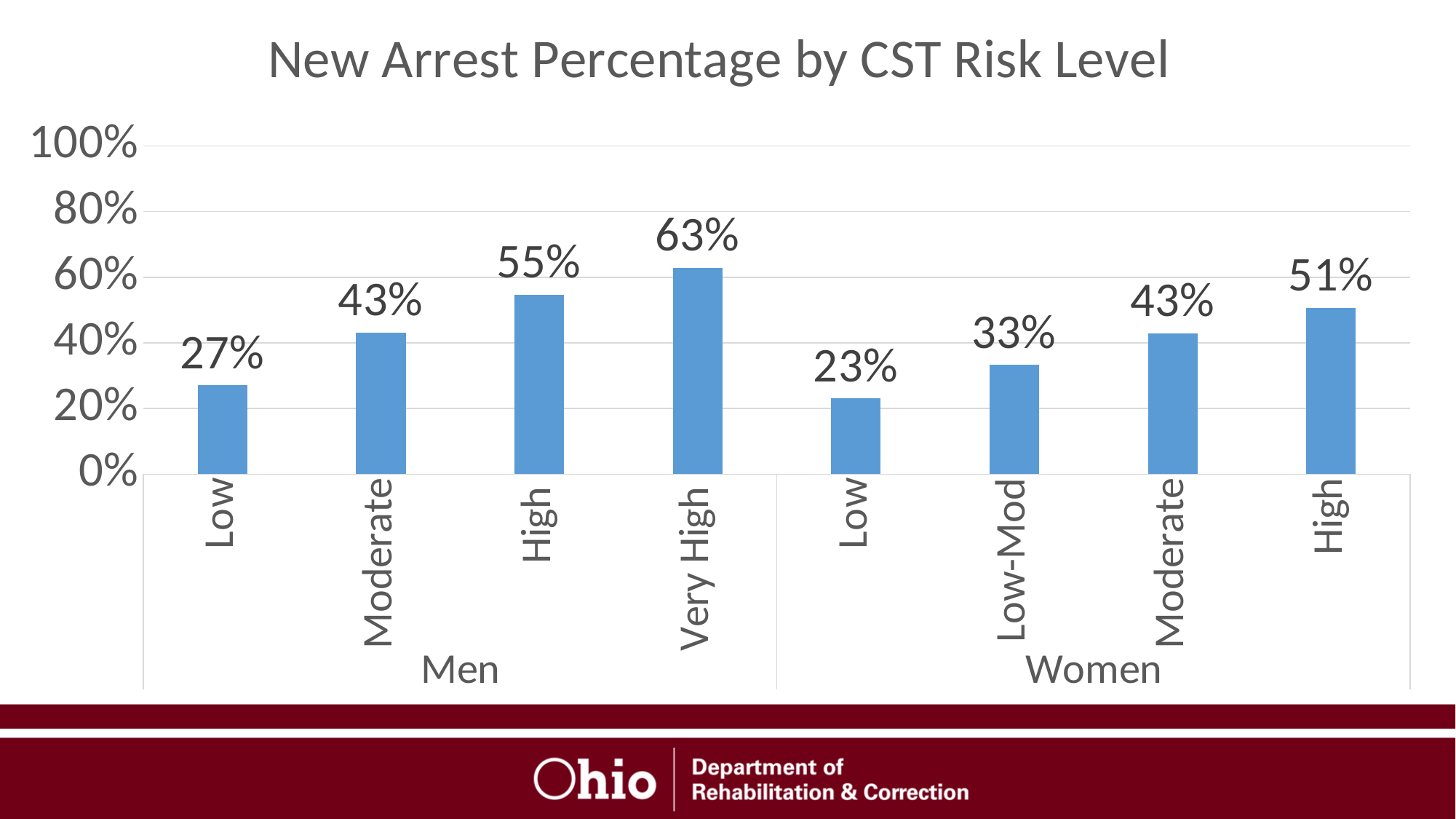
Is the new arrest percentage for Women at the Moderate risk level greater or less than 40%? greater How many bars are plotted in the chart? 8 What is the new arrest percentage for Men at the Low risk level? 27% What is the new arrest percentage for Men at the Very High risk level? 63% Which bar has the lowest new arrest percentage? Women, Low What is the new arrest percentage for Women at the Low-Mod risk level? 33% Which bar has the highest new arrest percentage? Men, Very High What is the title of the chart? New Arrest Percentage by CST Risk Level Which is larger: the new arrest percentage for Men at Low risk or Women at Low risk? Men at Low risk What kind of chart is shown on the slide? Bar chart Within the Men group, do the new arrest percentages rise or fall as risk level increases from Low to Very High? Rise What is the difference between the new arrest percentage for Men at High risk and Women at High risk? 4%